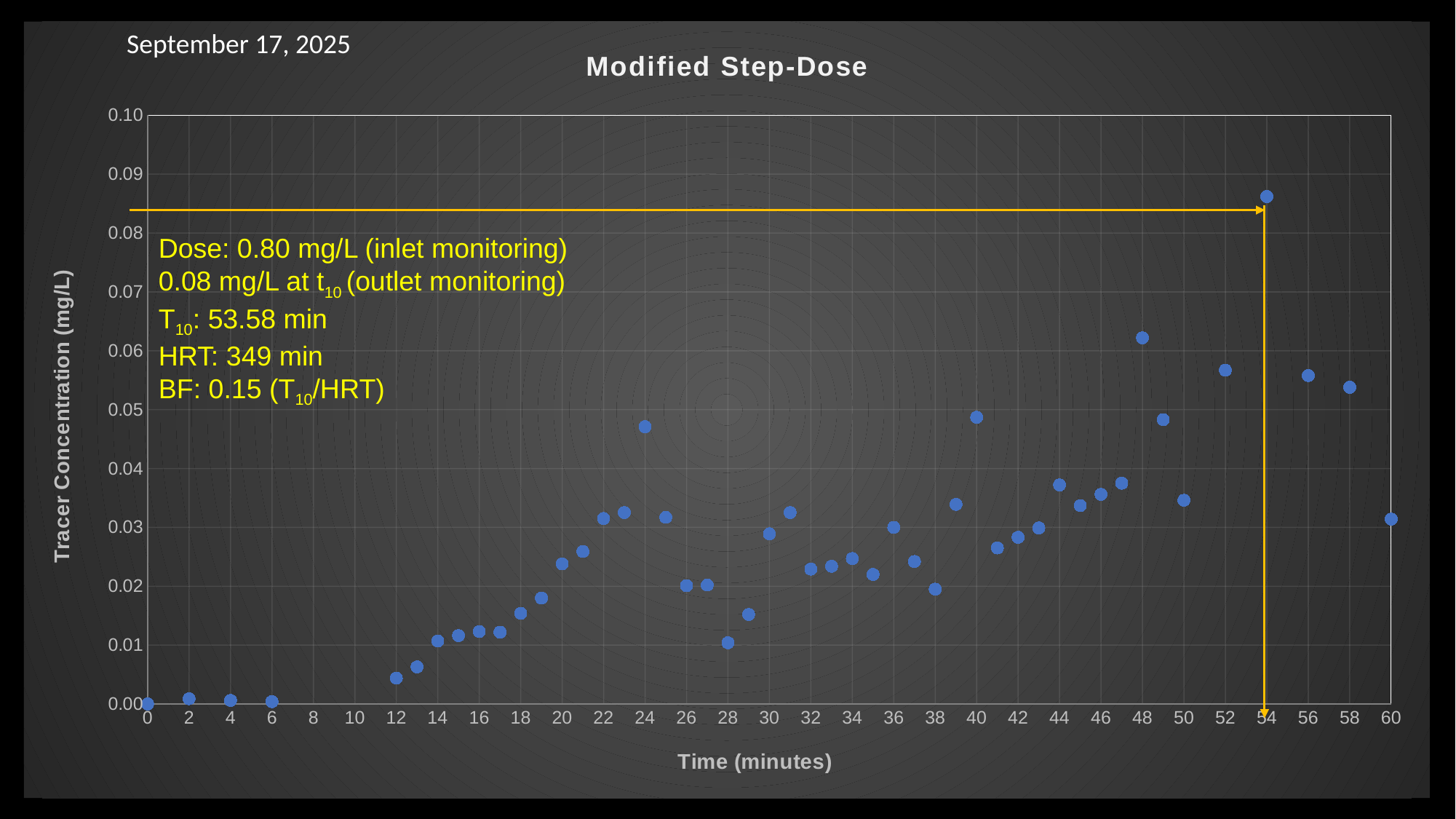
What is the tracer concentration at time 0 minutes? 0.00 Overall, does the tracer concentration rise or fall as time increases from 0 to 60 minutes? Rise Is the tracer concentration at 24 minutes greater or less than 0.04? greater What is the title of the chart? Modified Step-Dose What is the label of the vertical axis of the chart? Tracer Concentration (mg/L) Is the tracer concentration at 12 minutes greater or less than 0.01? less Which has the higher tracer concentration: 24 minutes or 26 minutes? 24 minutes What kind of chart is shown on the slide? Scatter chart Is the tracer concentration at 28 minutes greater or less than 0.02? less At which time (in minutes) does the highest tracer concentration occur? 54